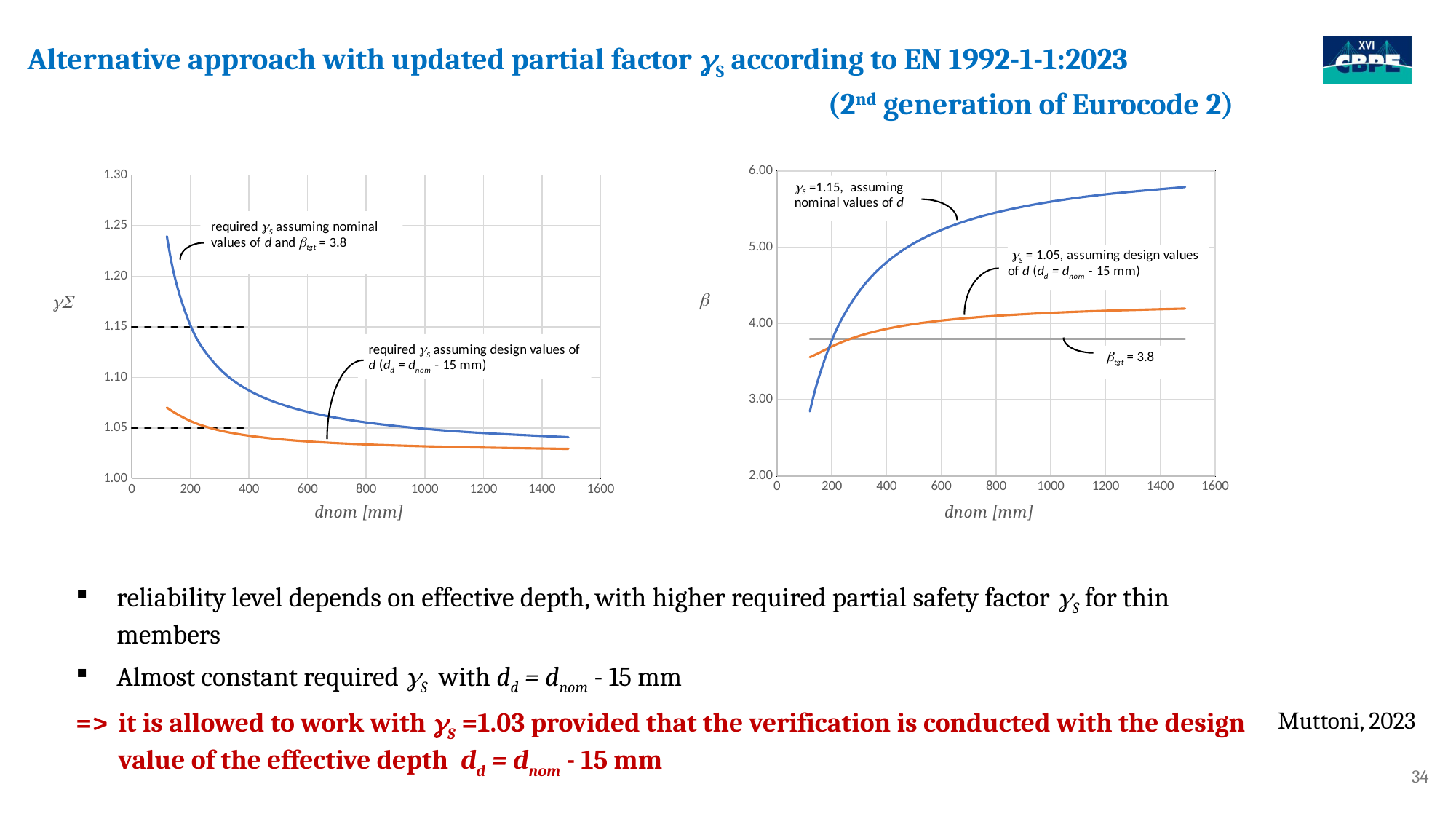
In the left chart, is the value of the curve for required γs assuming nominal values of d at dnom = 600 mm greater or less than 1.10? less What kind of chart is the left chart (γΣ versus dnom)? line chart In the left chart, is the value of the curve for required γs assuming design values of d at dnom = 1000 mm greater or less than 1.05? less How many curves are plotted in the left chart? 2 In the right chart (β versus dnom), does the curve for γs = 1.15 assuming nominal values of d rise or fall as dnom increases? rise In the right chart, is the value of the γs = 1.05 curve at dnom = 1400 mm greater or less than 4.00? greater What is the x-axis label of both charts? dnom [mm] In the left chart, at dnom = 400 mm, which curve is higher: required γs assuming nominal values of d, or required γs assuming design values of d? required γs assuming nominal values of d In the left chart, does the curve for required γs assuming nominal values of d rise or fall as dnom increases? fall In the right chart, at dnom = 1400 mm, which curve has the higher β: the γs = 1.15 curve or the γs = 1.05 curve? the γs = 1.15 curve In the right chart, what is the value of the horizontal grey line labelled βtgt? 3.8